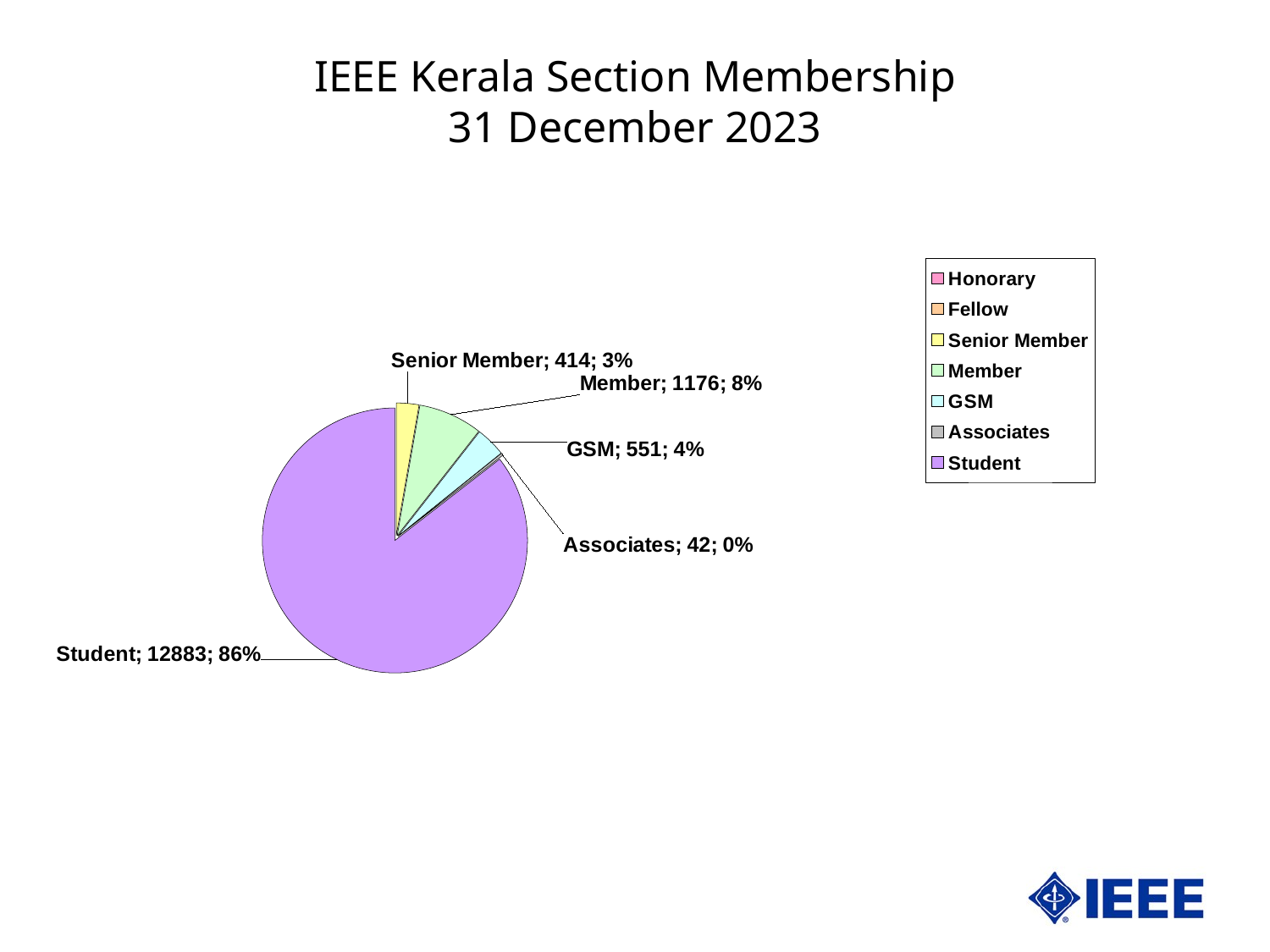
What kind of chart is shown on the slide? pie chart What is the number of Student members shown on the pie chart? 12883 What is the value shown for Member? 1176 What is the value shown for GSM? 551 Which is larger, the value for Senior Member or the value for GSM? GSM What share of the pie does the Student slice represent? 86% Which category has the largest slice of the pie? Student What percentage is shown for the Member slice? 8% What is the value shown for Senior Member? 414 What is the title of the chart on the slide? IEEE Kerala Section Membership 31 December 2023 How many membership categories does the legend list? 7 What is the difference between the Member value and the GSM value? 625